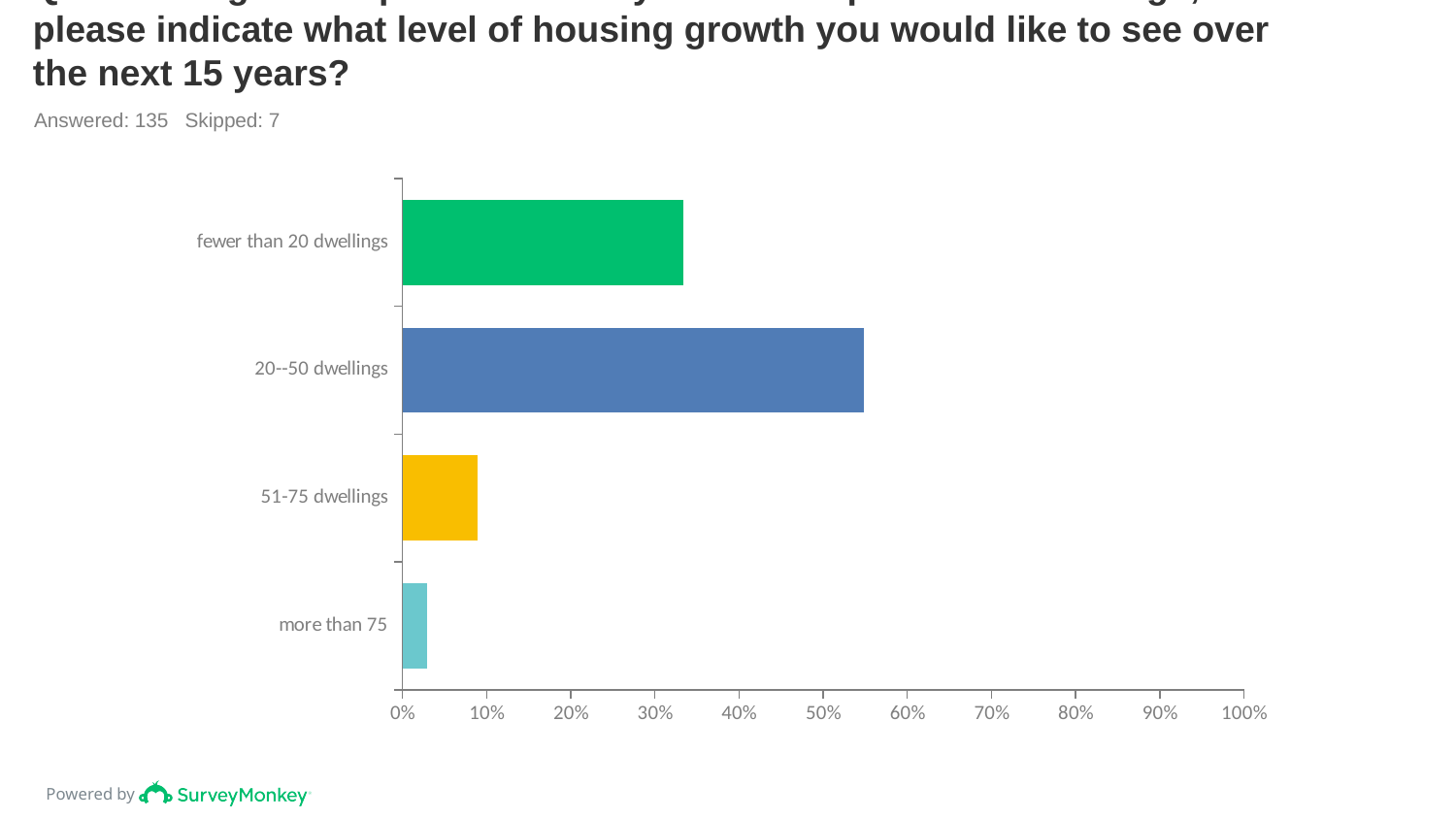
What is the maximum value shown on the horizontal axis? 100% Is the value for fewer than 20 dwellings greater or less than 40%? less Which is larger, the value for fewer than 20 dwellings or the value for 51-75 dwellings? fewer than 20 dwellings Which category has the lowest value? more than 75 Is the value for more than 75 greater or less than 10%? less How many respondents answered the question shown on the slide? 135 How many categories are shown in the chart? 4 Which is larger, the value for 20--50 dwellings or the value for fewer than 20 dwellings? 20--50 dwellings What kind of chart is shown on the slide? bar chart Is the value for 20--50 dwellings greater or less than 50%? greater Which category has the highest value? 20--50 dwellings